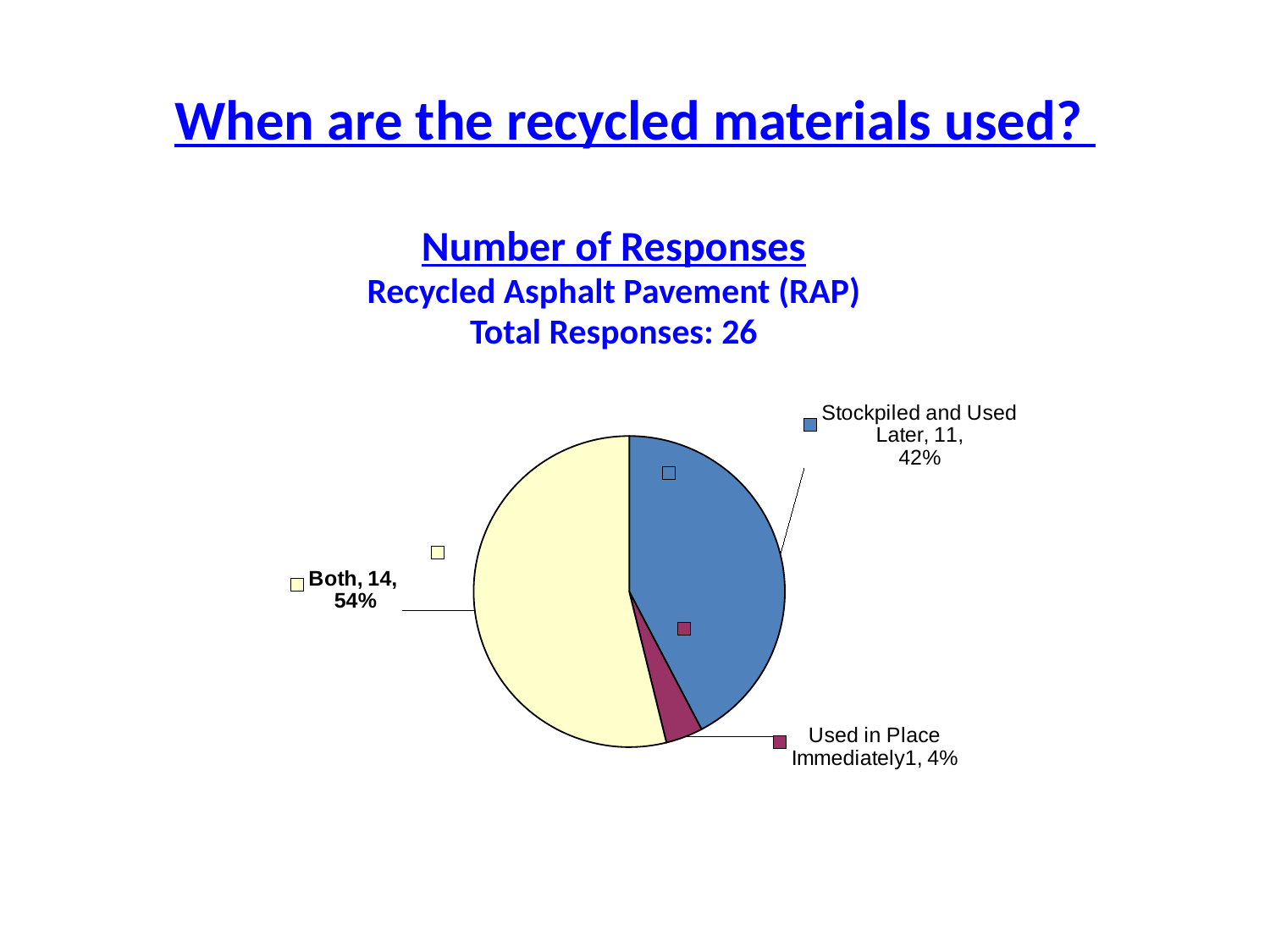
How many responses are in the 'Used in Place Immediately' slice? 1 Which category has the smallest slice of the pie? Used in Place Immediately What percentage share of the pie does 'Both' represent? 54% What percentage share of the pie does 'Stockpiled and Used Later' represent? 42% What kind of chart is shown on the slide? pie chart Which category has the largest slice of the pie? Both What is the total number of responses stated on the slide? 26 What is the difference in number of responses between 'Both' and 'Stockpiled and Used Later'? 3 How many responses are in the 'Stockpiled and Used Later' slice? 11 How many slices does the pie chart have? 3 How many responses are in the 'Both' slice? 14 What percentage share of the pie does 'Used in Place Immediately' represent? 4%